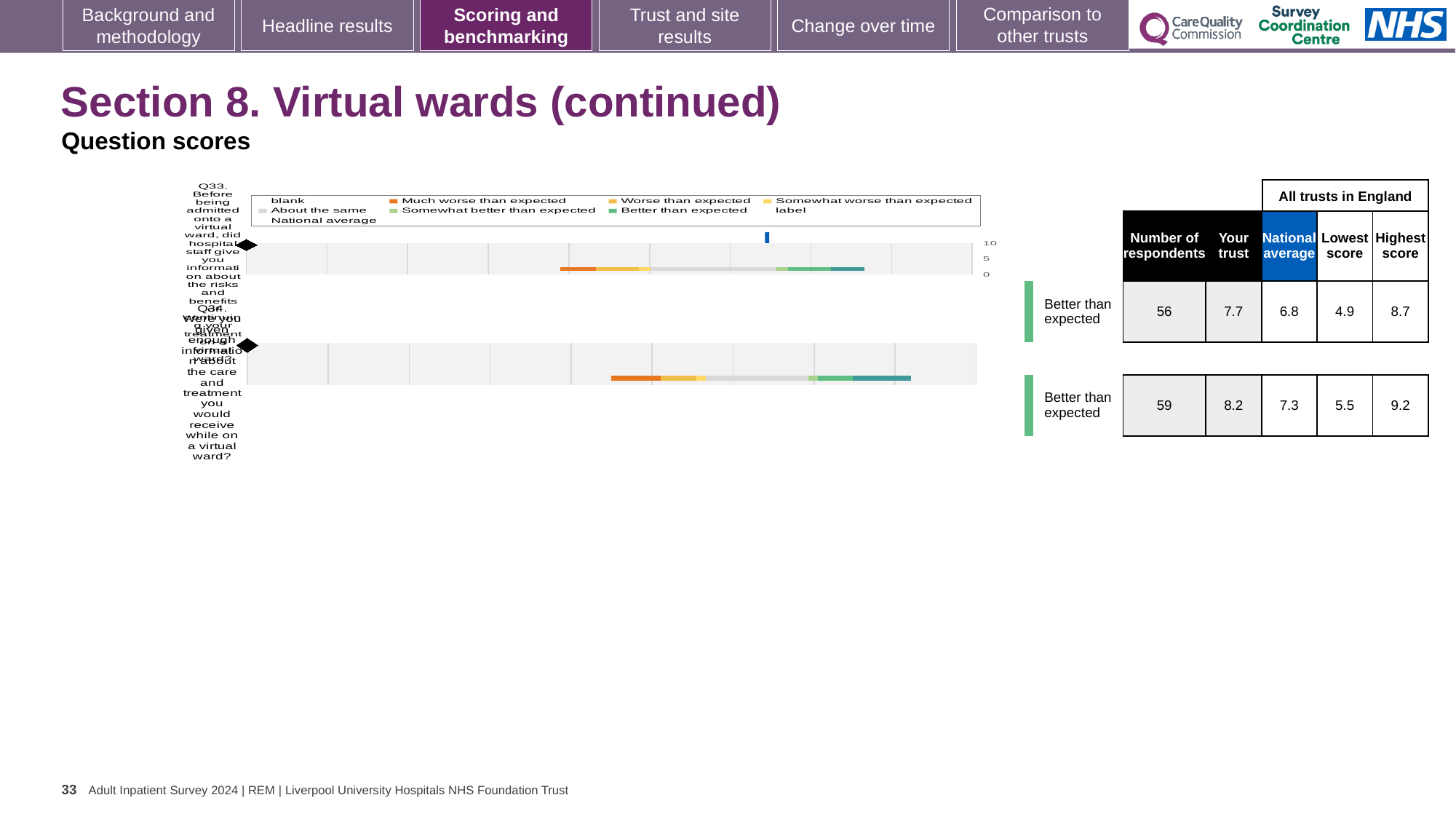
What is the difference between the trust's score and the national average for Q33? 0.9 What kind of chart is used to show the question scores on this slide? bar chart What is the highest score across all trusts in England for Q33? 8.7 What is the lowest score across all trusts in England for Q34? 5.5 What is the 'Your trust' score for Q33? 7.7 How many respondents answered Q34? 59 Which question has more respondents, Q33 or Q34? Q34 How many questions (categories) are plotted in the chart? 2 What is the difference between the highest and lowest scores in England for Q34? 3.7 Which question has the higher 'Your trust' score, Q33 or Q34? Q34 What is the national average score for Q34? 7.3 What benchmark category is shown for Q33 and Q34? Better than expected